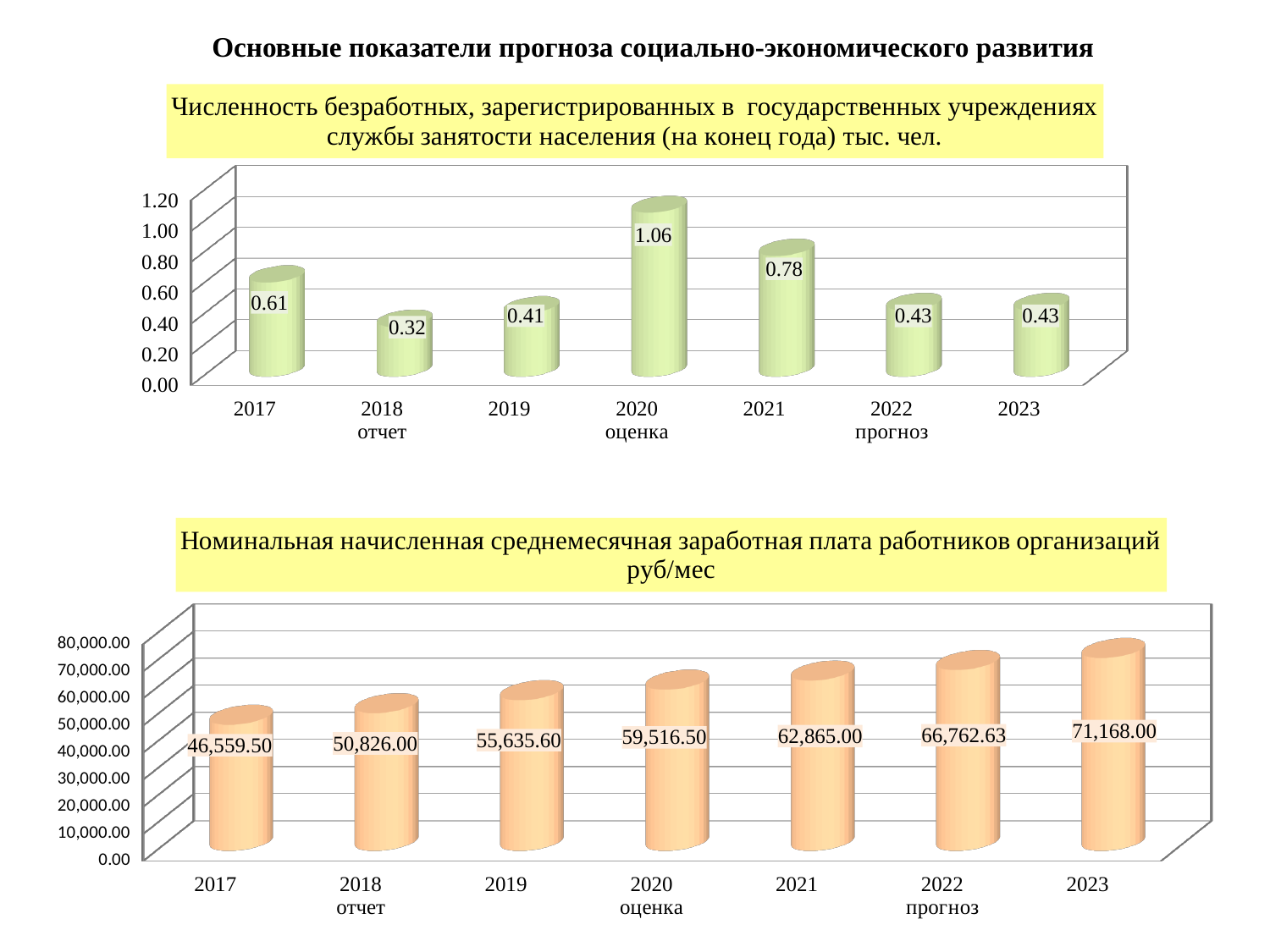
In the bottom chart (nominal average monthly wage), which year has the lowest value? 2017 In the top chart (unemployed registered in state employment services), which year has the lowest value? 2018 In the bottom chart (nominal average monthly wage), what is the difference between the 2018 and 2017 values? 4,266.50 In the bottom chart (nominal average monthly wage), what is the value for 2019? 55,635.60 In the top chart (unemployed registered in state employment services), what is the value for 2020? 1.06 In the bottom chart (nominal average monthly wage), do the values rise or fall from 2017 to 2023? rise In the top chart (unemployed registered in state employment services), what is the difference between the 2020 and 2021 values? 0.28 In the top chart (unemployed registered in state employment services), how many years are plotted? 7 What type of chart is the bottom chart (nominal average monthly wage)? bar chart In the top chart (unemployed registered in state employment services), is the value for 2017 larger or smaller than the value for 2019? larger In the bottom chart (nominal average monthly wage), what is the value for 2023? 71,168.00 In the top chart (unemployed registered in state employment services), which year has the highest value? 2020